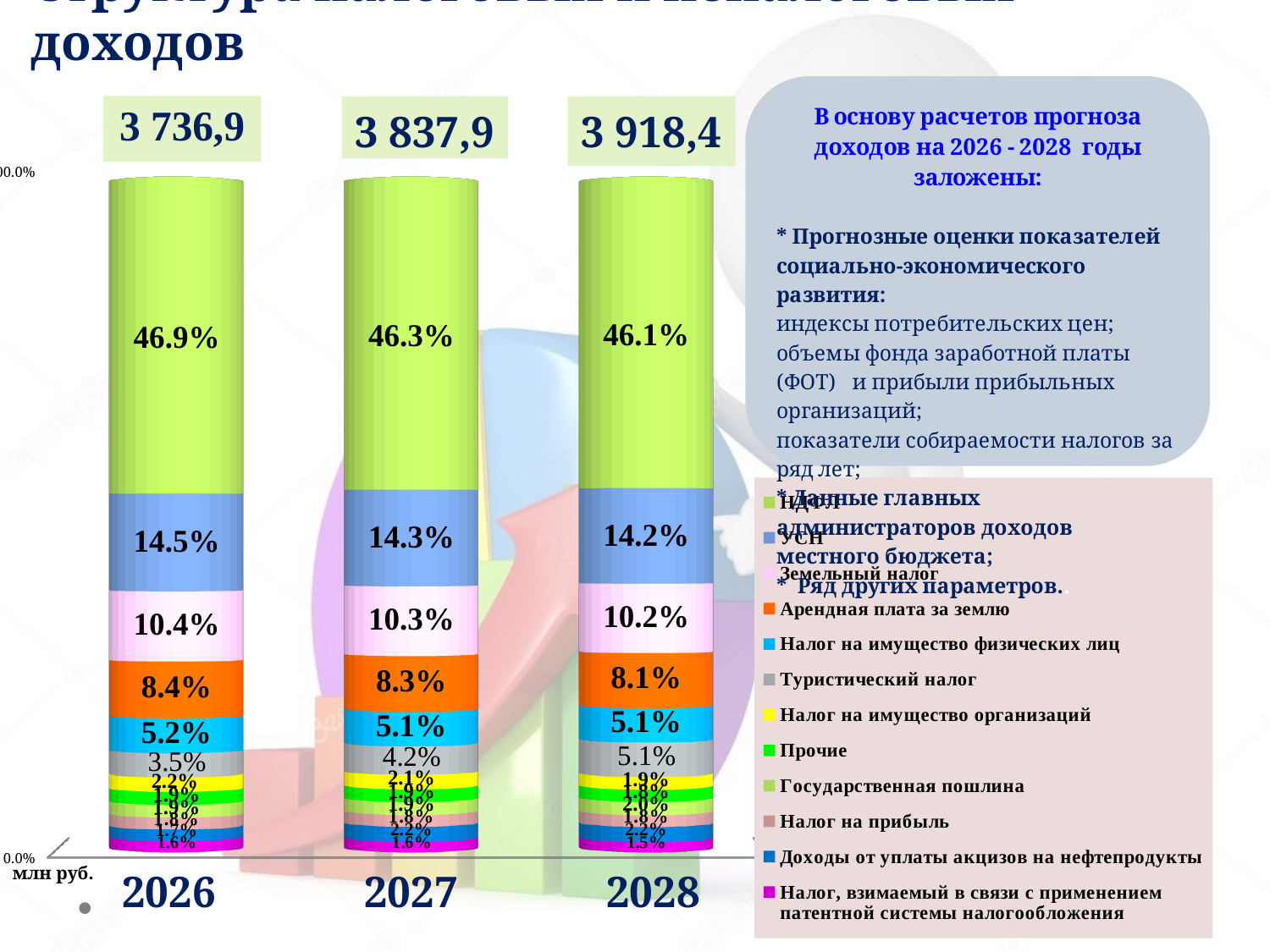
Is the share of Арендная плата за землю larger in 2026 or in 2028? 2026 Which revenue source has the largest share in the 2026 bar? НДФЛ By how many percentage points does the НДФЛ share in 2026 exceed its share in 2028? 0.8 Does the share of Туристический налог rise or fall from 2026 to 2028? rise How many years (bars) are shown in the chart? 3 What share does Земельный налог have in the 2028 bar? 10.2% What total value (млн руб.) is shown above the 2027 bar? 3 837,9 What is the share of УСН in 2027? 14.3% What is the share of Туристический налог in 2027? 4.2% What share does НДФЛ account for in the 2026 bar? 46.9% What type of chart is shown on the slide? stacked bar chart How many revenue sources does the legend list? 12